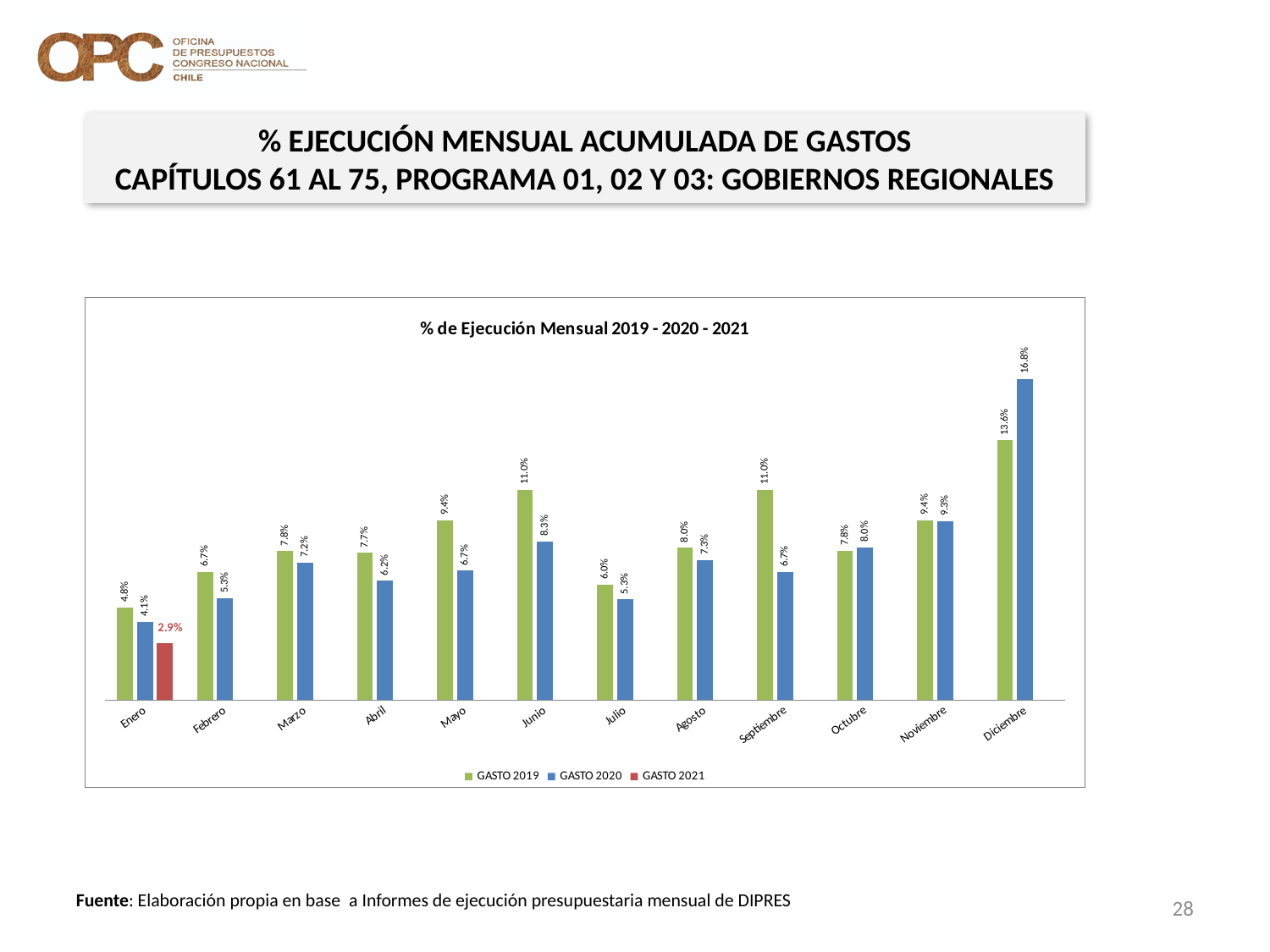
In Mayo, which is larger: GASTO 2019 or GASTO 2020? GASTO 2019 What is the title of the chart? % de Ejecución Mensual 2019 - 2020 - 2021 What is the difference between GASTO 2019 and GASTO 2020 in Septiembre? 4.3% What is the value for GASTO 2021 in Enero? 2.9% How many months are shown on the x axis? 12 What is the difference between GASTO 2020 and GASTO 2019 in Diciembre? 3.2% Which month has the lowest value for GASTO 2019? Enero What kind of chart is shown on the slide? Bar chart How many series does the legend list? 3 What is the value for GASTO 2020 in Diciembre? 16.8% Which month has the highest value for GASTO 2020? Diciembre What is the value for GASTO 2019 in Junio? 11.0%